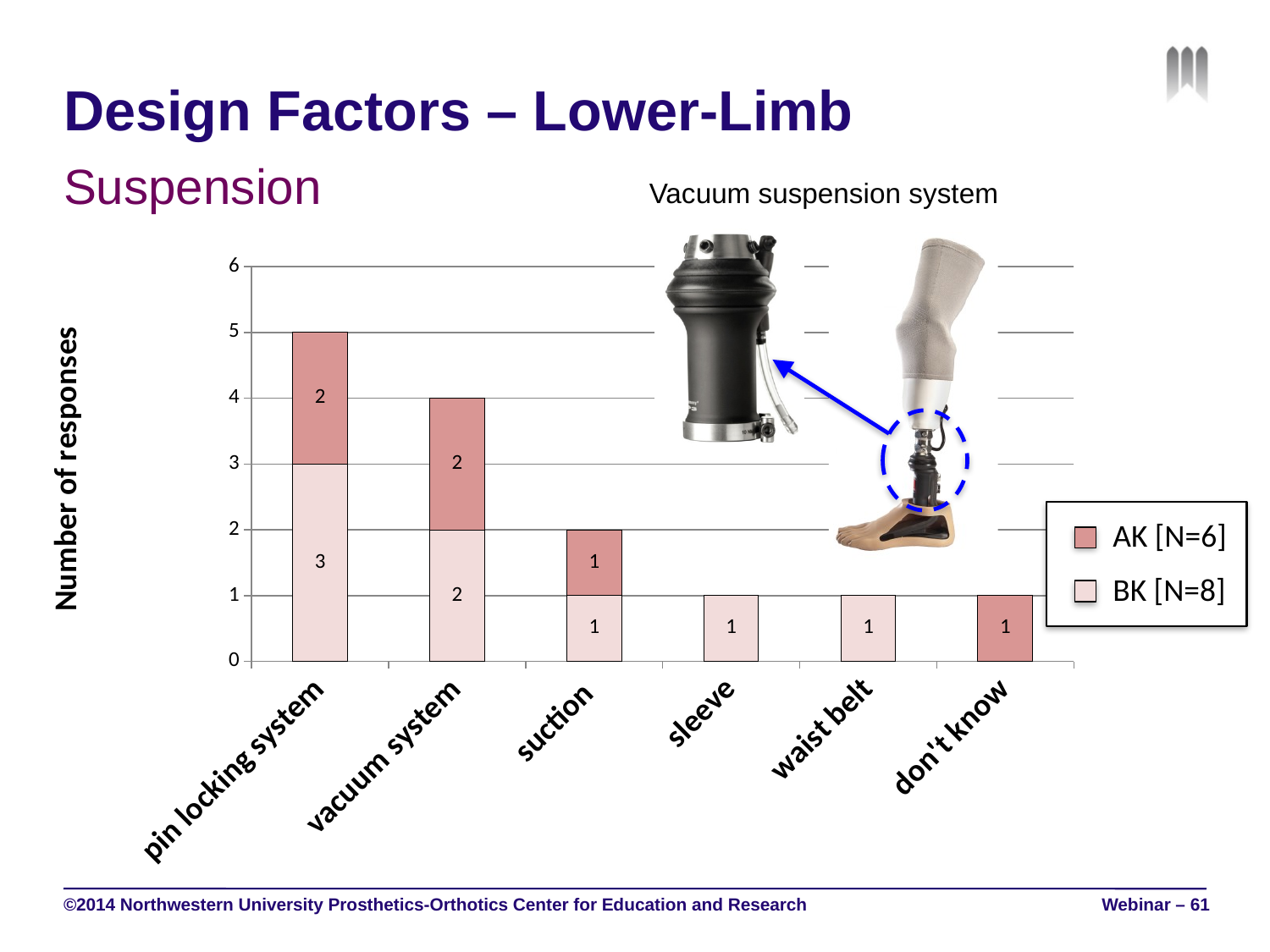
How many categories are shown on the x axis? 6 What is the AK [N=6] value for vacuum system? 2 How many series does the legend list? 2 What is the total number of responses for the pin locking system bar? 5 What is the BK [N=8] value for pin locking system? 3 What is the difference between the BK [N=8] value for pin locking system and the BK [N=8] value for vacuum system? 1 What is the label of the y axis? Number of responses Which category has the highest total number of responses? pin locking system What kind of chart is shown on the slide? stacked bar chart What is the total number of responses for the vacuum system bar? 4 What is the AK [N=6] value for don't know? 1 Which is larger: the total for suction or the total for sleeve? suction